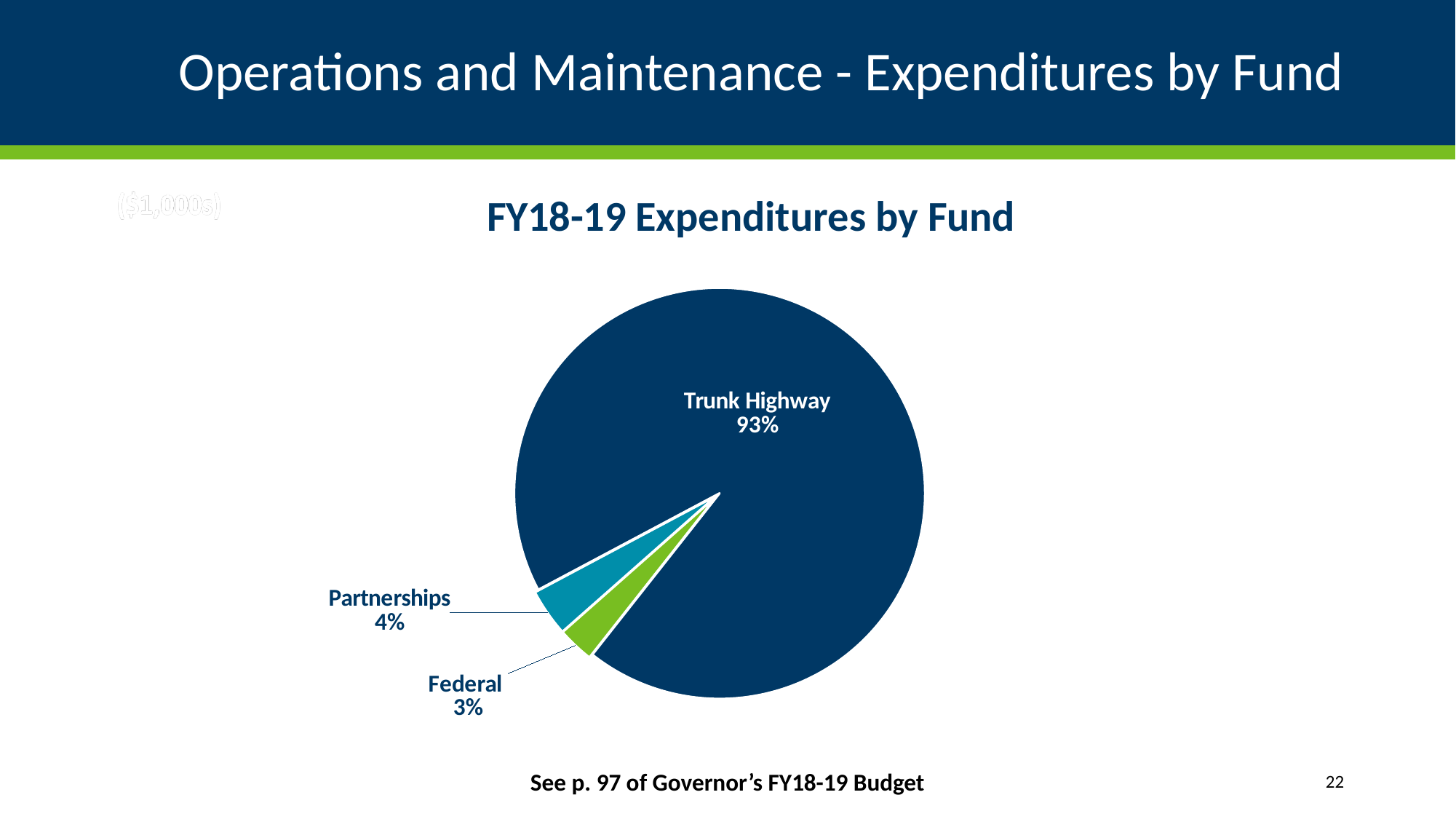
What is the difference in percentage points between the Partnerships share and the Federal share? 1 What is the title of the chart? FY18-19 Expenditures by Fund What colour is the Federal slice of the pie? green What is the difference in percentage points between the Trunk Highway share and the Partnerships share? 89 What share of expenditures comes from Partnerships? 4% What type of chart is shown on the slide? pie chart Which is larger, the Partnerships share or the Federal share? Partnerships Which fund has the smallest share of expenditures? Federal What share of expenditures comes from the Federal fund? 3% Which fund has the largest share of expenditures? Trunk Highway What share of expenditures comes from the Trunk Highway fund? 93% How many slices does the pie chart have? 3